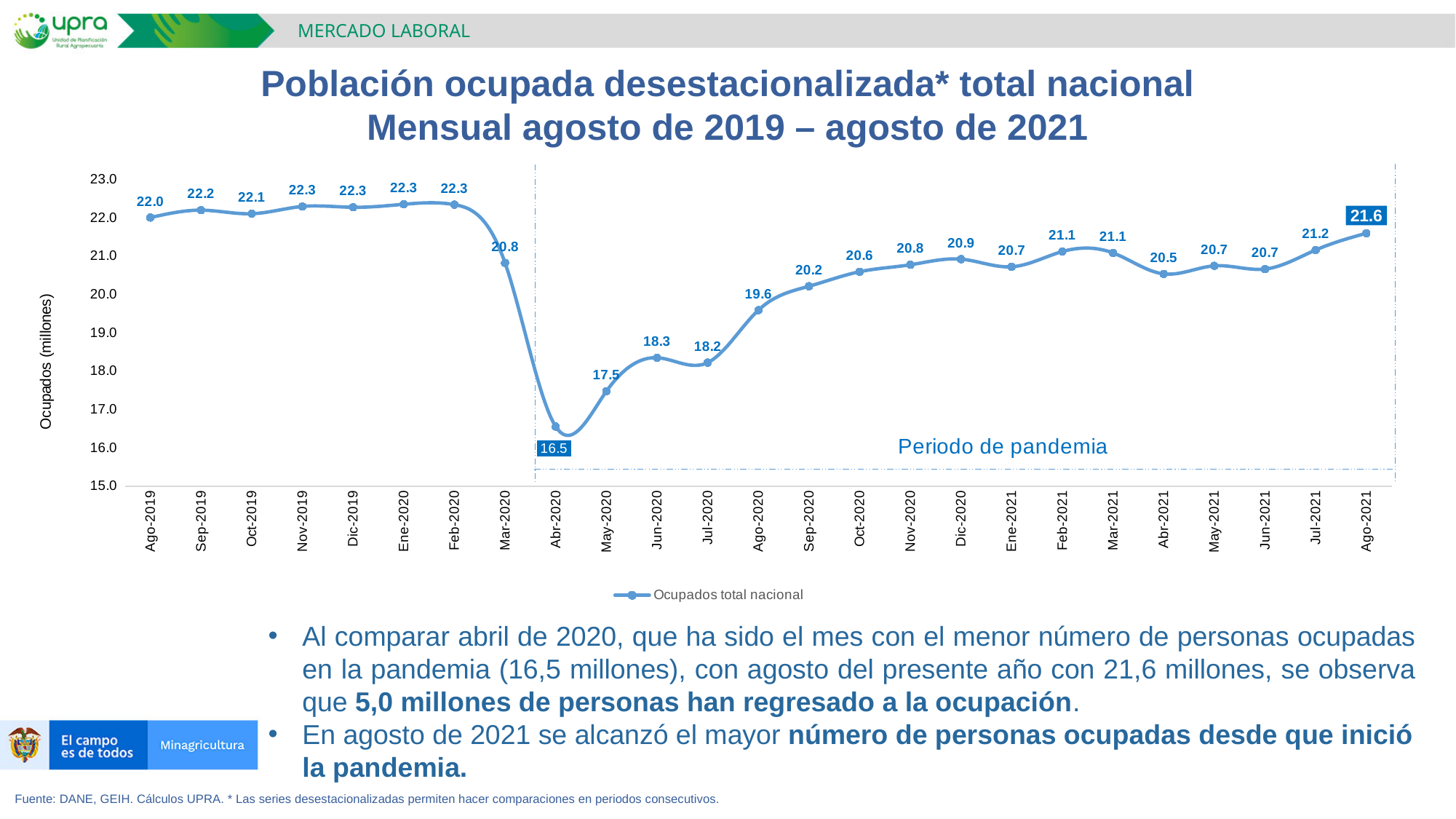
What is the label on the y axis? Ocupados (millones) What is the value for Mar-2020? 20.8 What is the difference between the values for Feb-2020 and Mar-2020? 1.5 How many series does the legend list? 1 What type of chart is shown on the slide? line chart What is the difference between the values for Ago-2021 and Abr-2020? 5.1 What is the value for Abr-2020? 16.5 Which month has the lowest value? Abr-2020 What is the value for Ago-2021? 21.6 What is the value for Ago-2019? 22.0 How many data points are plotted on the chart? 25 Which is larger, the value for Jun-2020 or the value for Jul-2020? Jun-2020